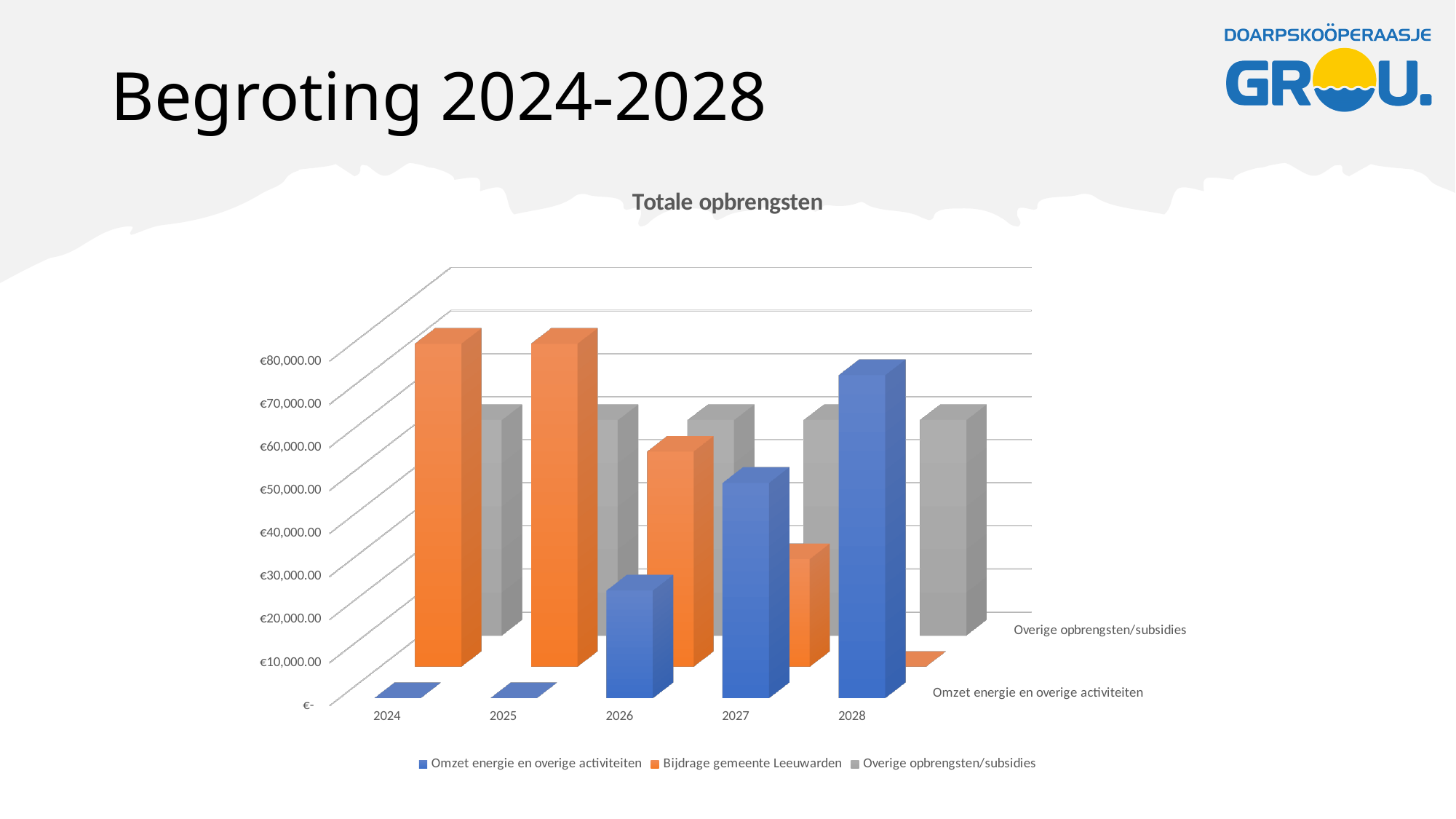
Which is larger for Bijdrage gemeente Leeuwarden: the value in 2024 or the value in 2027? 2024 Do the values for Bijdrage gemeente Leeuwarden rise or fall from 2024 to 2028? fall In which year is the value for Omzet energie en overige activiteiten highest? 2028 What kind of chart is shown on the slide? bar chart Is the value for Omzet energie en overige activiteiten in 2024 greater or less than €10,000.00? less Is the value for Omzet energie en overige activiteiten in 2028 greater or less than €50,000.00? greater How many years are shown on the x axis? 5 Which series is shown in orange in the legend? Bijdrage gemeente Leeuwarden In which year is the value for Bijdrage gemeente Leeuwarden lowest? 2028 What is the title of the chart? Totale opbrengsten Do the values for Omzet energie en overige activiteiten rise or fall from 2024 to 2028? rise How many series does the legend list? 3